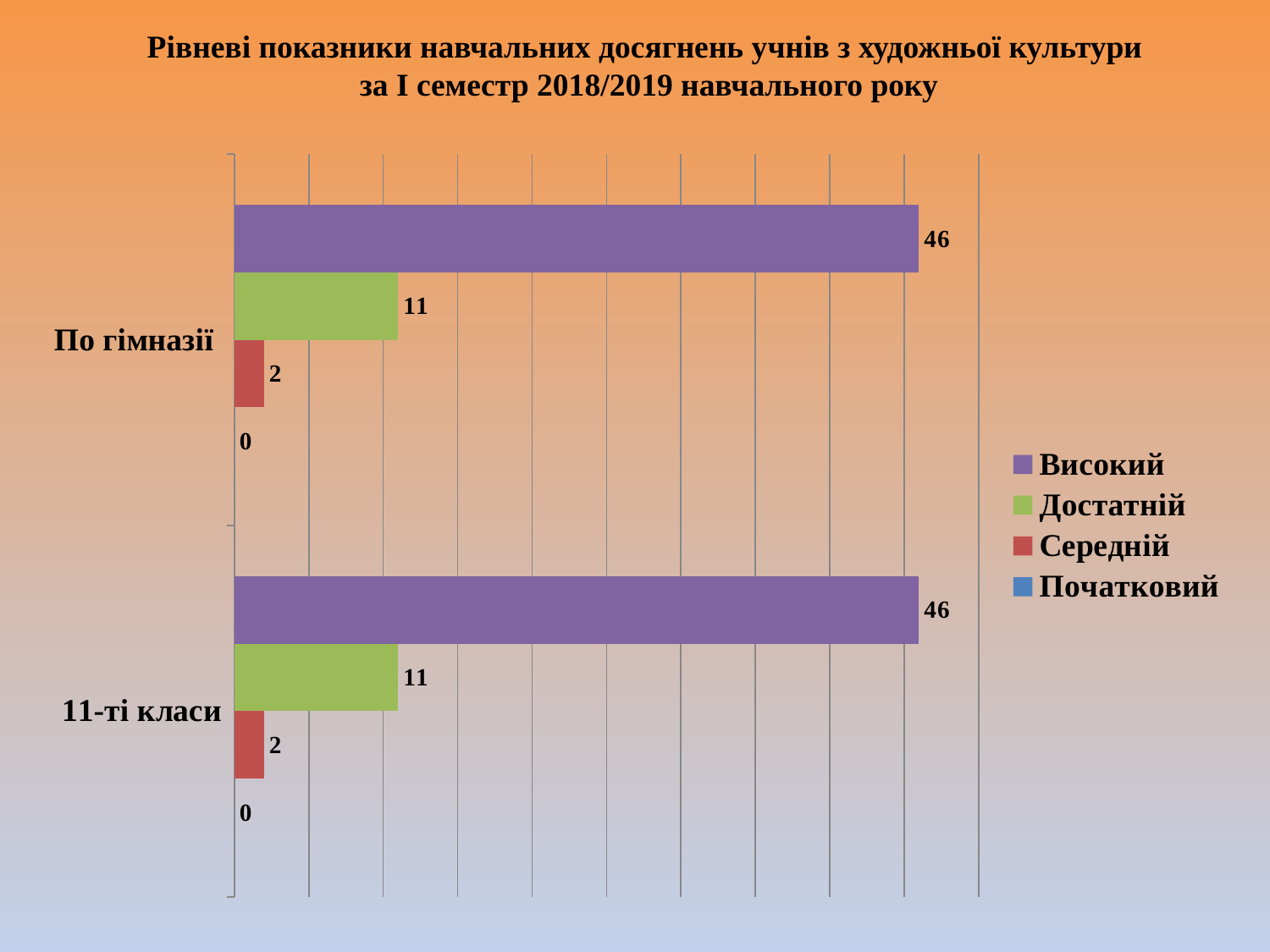
Which series has the lowest value in the 11-ті класи category? Початковий How many series does the legend list? 4 What is the value for Достатній in the По гімназії category? 11 What is the difference between the Високий and Достатній values in the 11-ті класи category? 35 Which series has the highest value in the По гімназії category? Високий What is the difference between the Достатній and Середній values in the По гімназії category? 9 Which is larger in the По гімназії category: Достатній or Середній? Достатній How many categories are shown on the chart? 2 What is the value for Початковий in the По гімназії category? 0 What is the value for Високий in the 11-ті класи category? 46 What is the value for Середній in the 11-ті класи category? 2 What kind of chart is shown on the slide? Bar chart